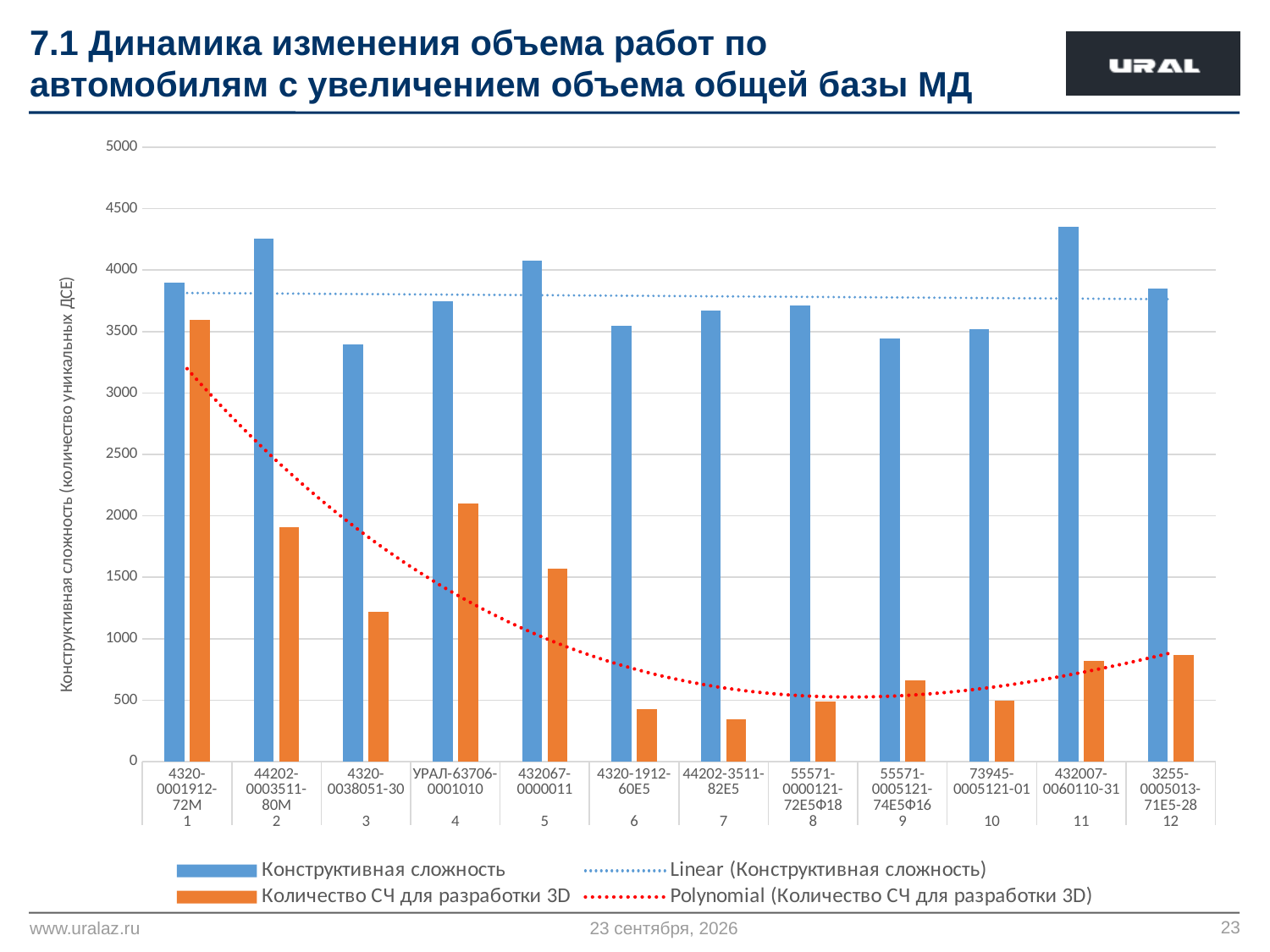
How many entries does the legend list? 4 Which has the larger value of Количество СЧ для разработки 3D: 44202-0003511-80М or УРАЛ-63706-0001010? УРАЛ-63706-0001010 For 4320-0001912-72М, which is larger: Конструктивная сложность or Количество СЧ для разработки 3D? Конструктивная сложность Is the value of Конструктивная сложность for 4320-0038051-30 greater or less than 3500? less Is the value of Количество СЧ для разработки 3D for 4320-0001912-72М greater or less than 3500? greater How many categories (vehicle models) are shown on the x axis? 12 What kind of chart is shown on the slide? bar chart Is the value of Конструктивная сложность for 44202-0003511-80М greater or less than 4000? greater What is the title of the vertical axis? Конструктивная сложность (количество уникальных ДСЕ) Which category has the highest value for Количество СЧ для разработки 3D? 4320-0001912-72М